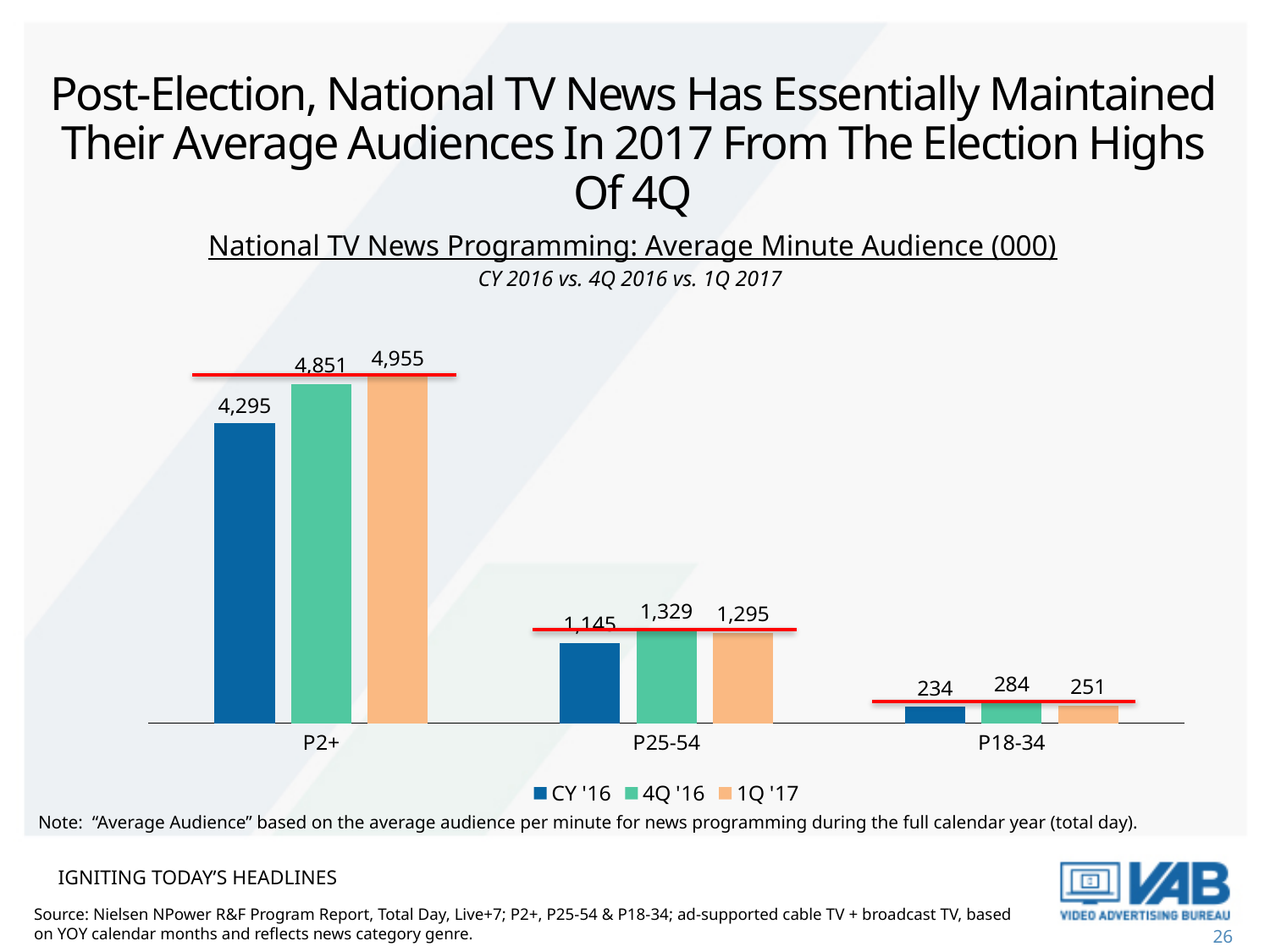
What is the 1Q '17 average minute audience (000) for P2+? 4,955 What is the CY '16 value for P25-54? 1,145 What is the 4Q '16 value for P18-34? 284 What is the difference between the 4Q '16 and 1Q '17 values for P25-54? 34 Which demographic has the lowest 1Q '17 value? P18-34 For P18-34, which is larger: the 4Q '16 value or the 1Q '17 value? 4Q '16 What is the title of the chart? National TV News Programming: Average Minute Audience (000) What kind of chart is shown on the slide? Bar chart What is the difference between the 4Q '16 and CY '16 values for P2+? 556 How many series does the legend list? 3 How many demographic categories are shown on the x axis? 3 Which demographic has the highest CY '16 value? P2+